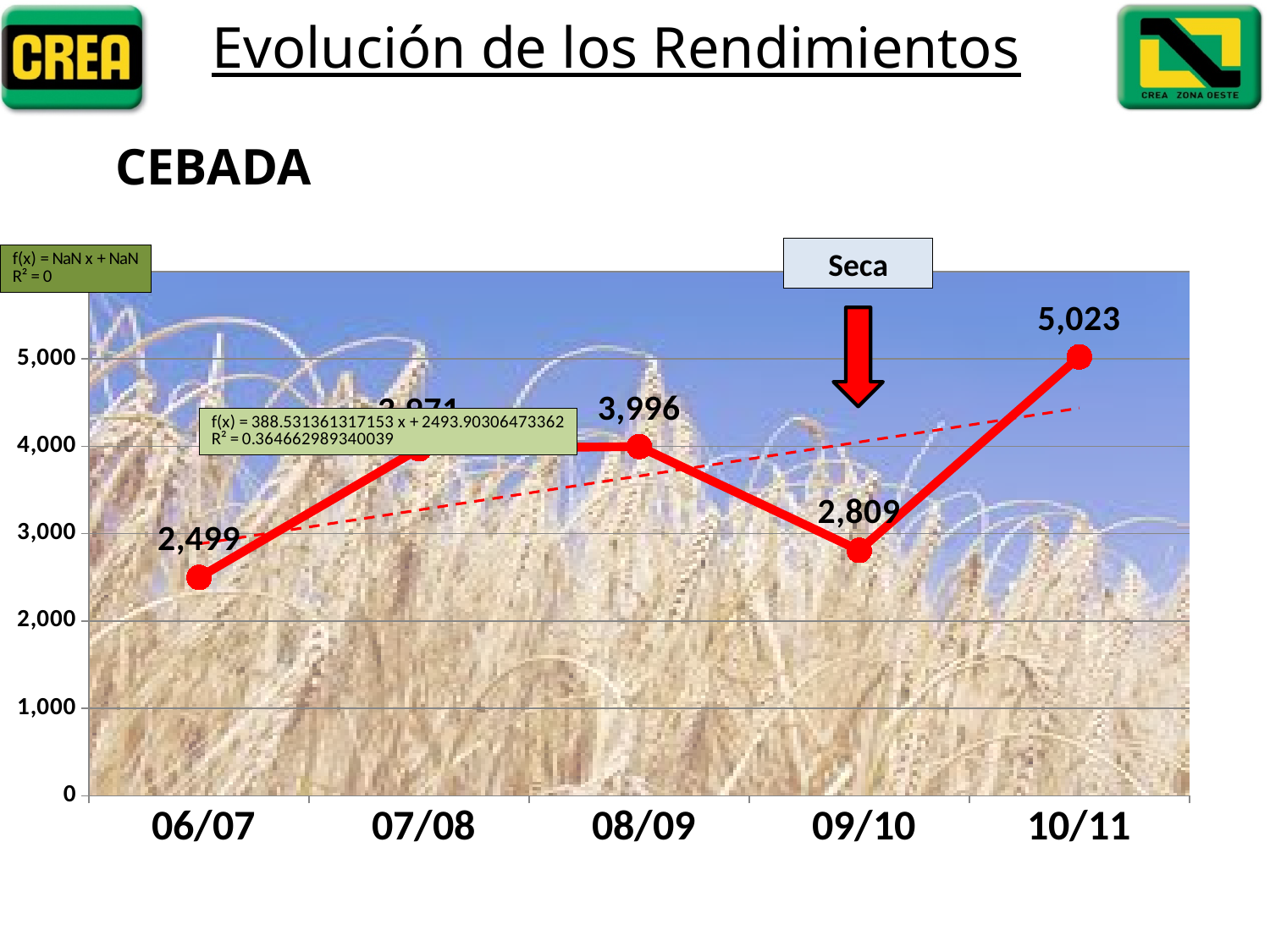
What kind of chart is shown? line chart What is the value for 10/11? 5,023 How many seasons are plotted on the x axis? 5 Which season has the highest value? 10/11 What is the value for 08/09? 3,996 Is the value for 07/08 greater or less than 3,000? greater What is the value for 09/10? 2,809 What is the value for 06/07? 2,499 What is the difference between the values for 10/11 and 09/10? 2,214 Which is larger, the value for 08/09 or the value for 09/10? 08/09 Which season has the lowest value? 06/07 Which season does the 'Seca' annotation arrow point to? 09/10